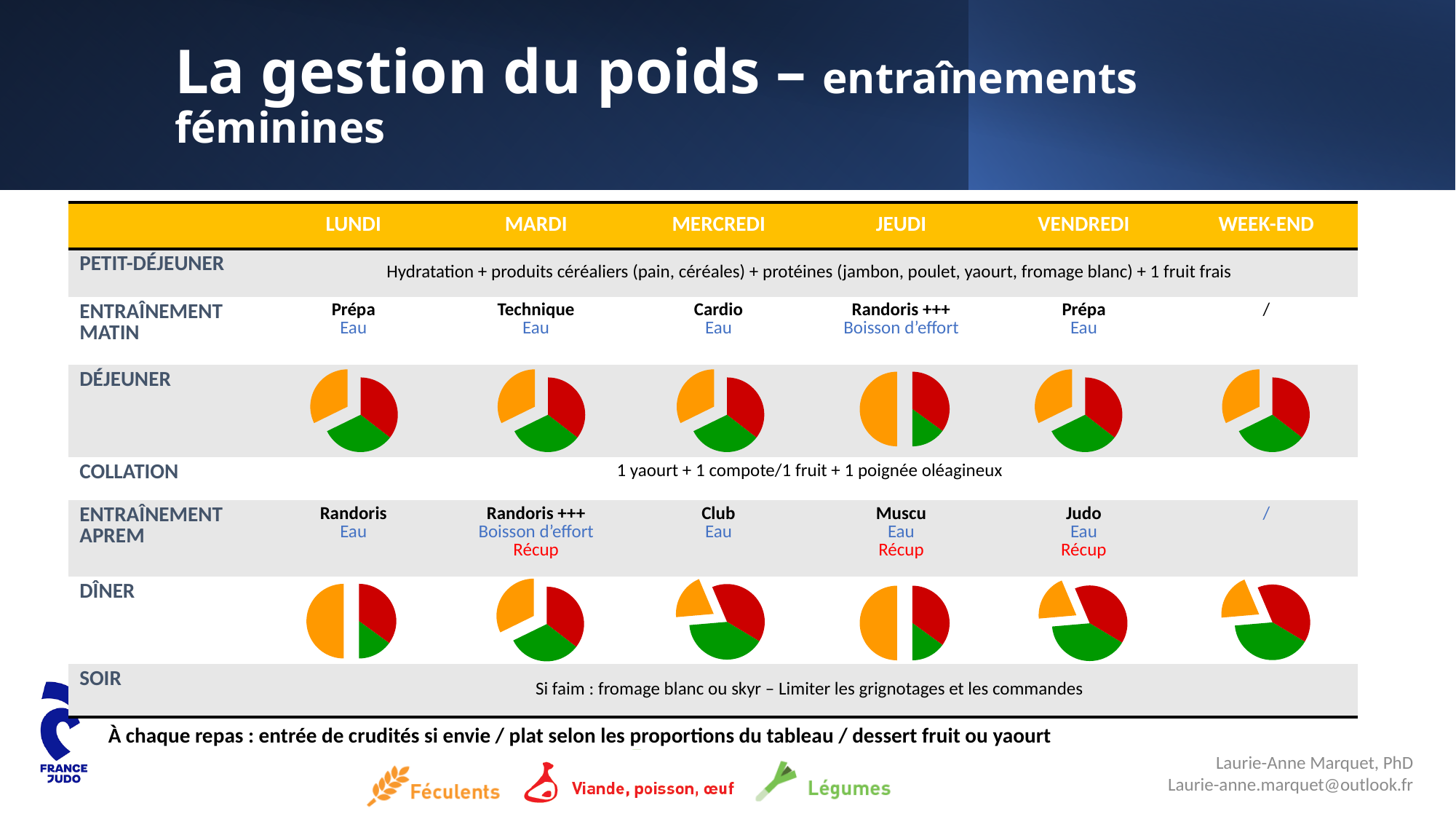
In the Vendredi Dîner pie chart, which food category has the smallest slice? Féculents In the Mercredi Dîner pie chart, which food category has the smallest slice? Féculents How many food categories does the legend at the bottom of the slide list? 3 In the Week-end Dîner pie chart, is the Féculents slice larger or smaller than the Légumes slice? Smaller Which food category does the orange colour in the pie charts represent? Féculents What kind of charts are used in the Déjeuner and Dîner rows of the table? Pie charts In the Lundi Dîner pie chart, is the Féculents slice larger or smaller than the Légumes slice? Larger In the Lundi Dîner pie chart, which food category has the largest slice? Féculents In the Jeudi Dîner pie chart, which food category has the largest slice? Féculents In the Jeudi Déjeuner pie chart, which food category has the largest slice? Féculents Which food category does the green colour in the pie charts represent? Légumes How many pie charts are shown on the slide in total? 12